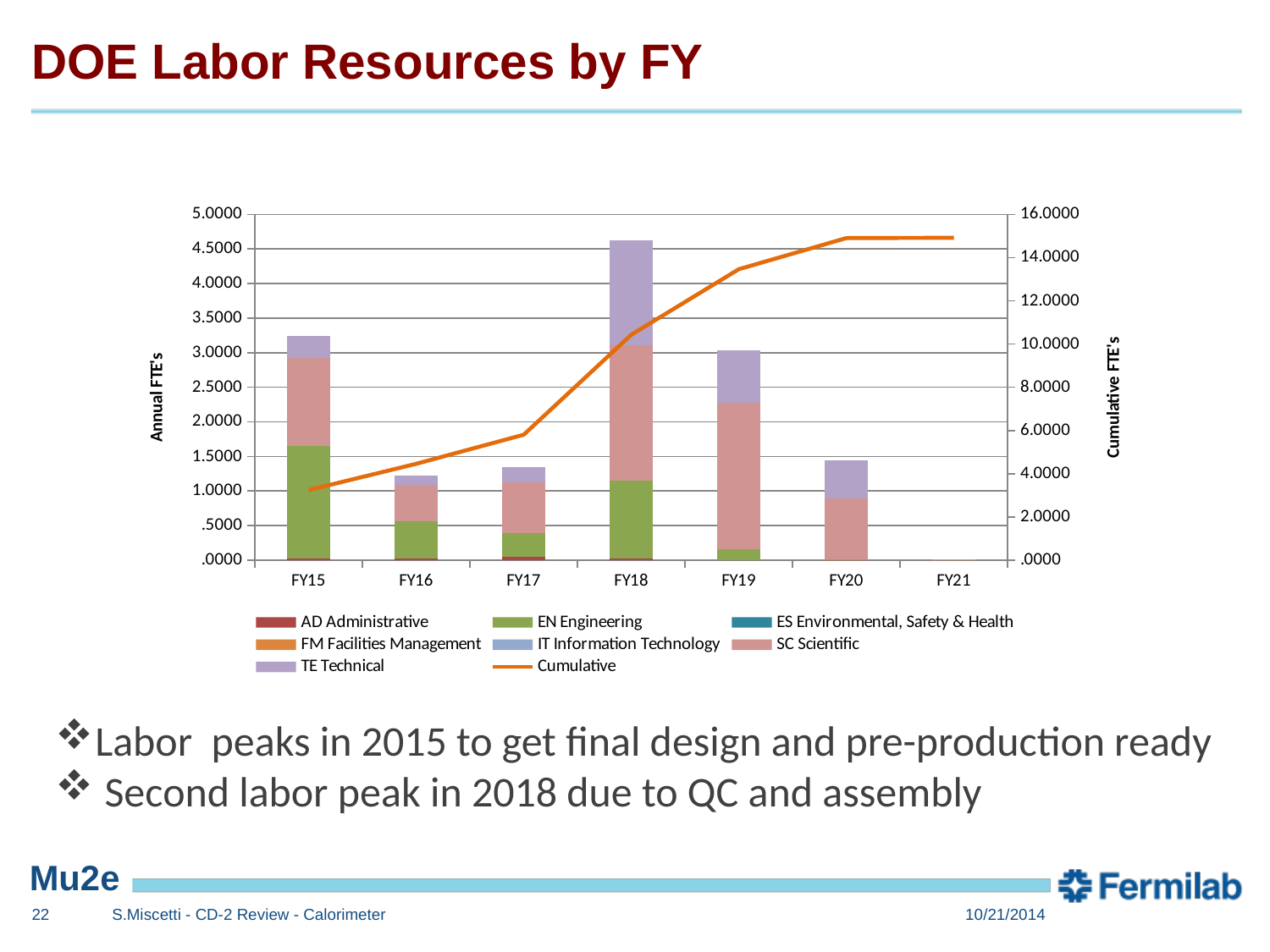
Which has the larger total annual FTE's, FY18 or FY15? FY18 What kind of chart is shown on the slide? Stacked bar chart with a line What is the title of the left vertical axis? Annual FTE's Is the Cumulative value at FY21 greater or less than 14.0000 on the right axis? greater Does the Cumulative line rise or fall from FY15 to FY20? rise Is the total annual FTE's for FY18 greater or less than 4.0000? greater How many fiscal years are shown on the x axis? 7 Is the total annual FTE's for FY20 greater or less than 2.0000? less How many series does the legend list? 8 Which fiscal year has the tallest stacked bar of annual FTE's? FY18